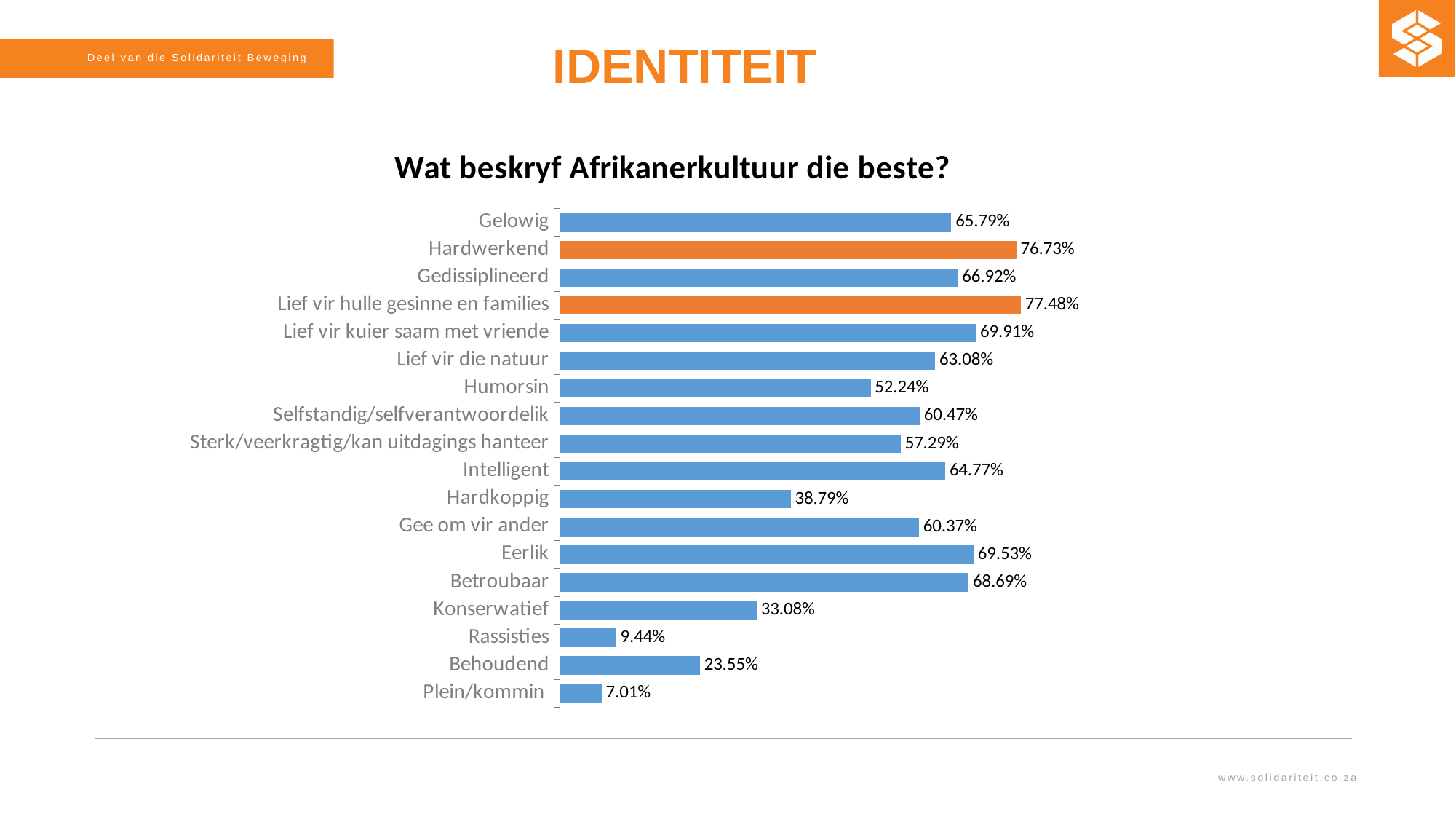
What is the difference between the values for Behoudend and Rassisties? 14.11 percentage points Which category has the highest value? Lief vir hulle gesinne en families Which two categories are highlighted with orange bars? Hardwerkend and Lief vir hulle gesinne en families What is the value for Humorsin? 52.24% Which is larger, the value for Gelowig or the value for Intelligent? Gelowig Which category has the lowest value? Plein/kommin What kind of chart is shown on the slide? Bar chart What is the value for Hardwerkend? 76.73% What is the value for Rassisties? 9.44% How many categories are shown in the chart? 18 What is the difference between the values for Lief vir hulle gesinne en families and Hardwerkend? 0.75 percentage points What is the value for Betroubaar? 68.69%